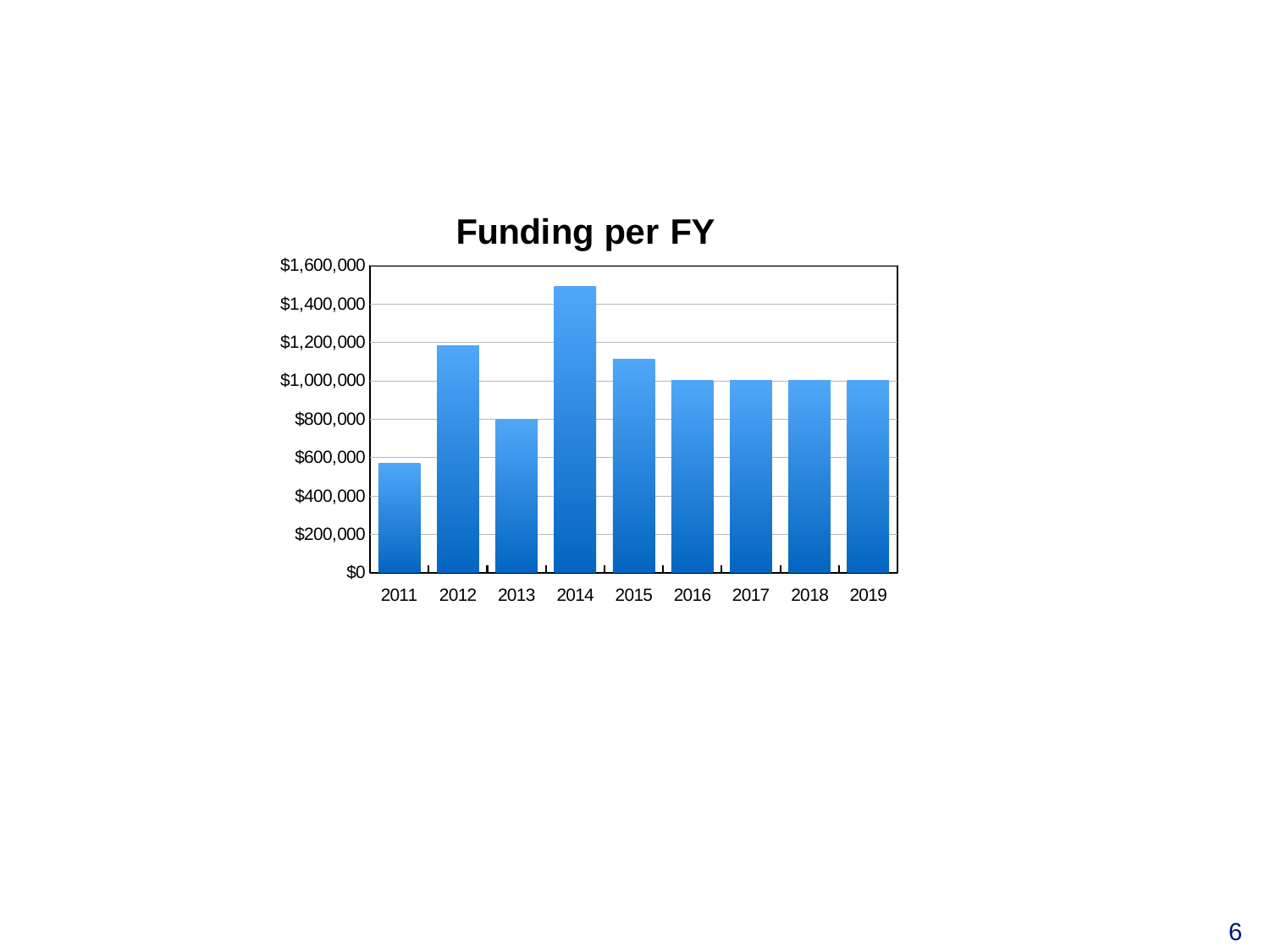
Is the funding for 2015 greater or less than $1,200,000? less Is the funding for 2011 greater or less than $600,000? less Is the funding for 2012 greater or less than $1,000,000? greater Which fiscal year has the highest funding? 2014 Which fiscal year has the lowest funding? 2011 What type of chart is shown on the slide? bar chart Does funding rise or fall from 2011 to 2012? rise What is the title of the chart? Funding per FY Does funding rise or fall from 2014 to 2015? fall How many fiscal years are shown on the x axis of the chart? 9 Which year has higher funding, 2012 or 2013? 2012